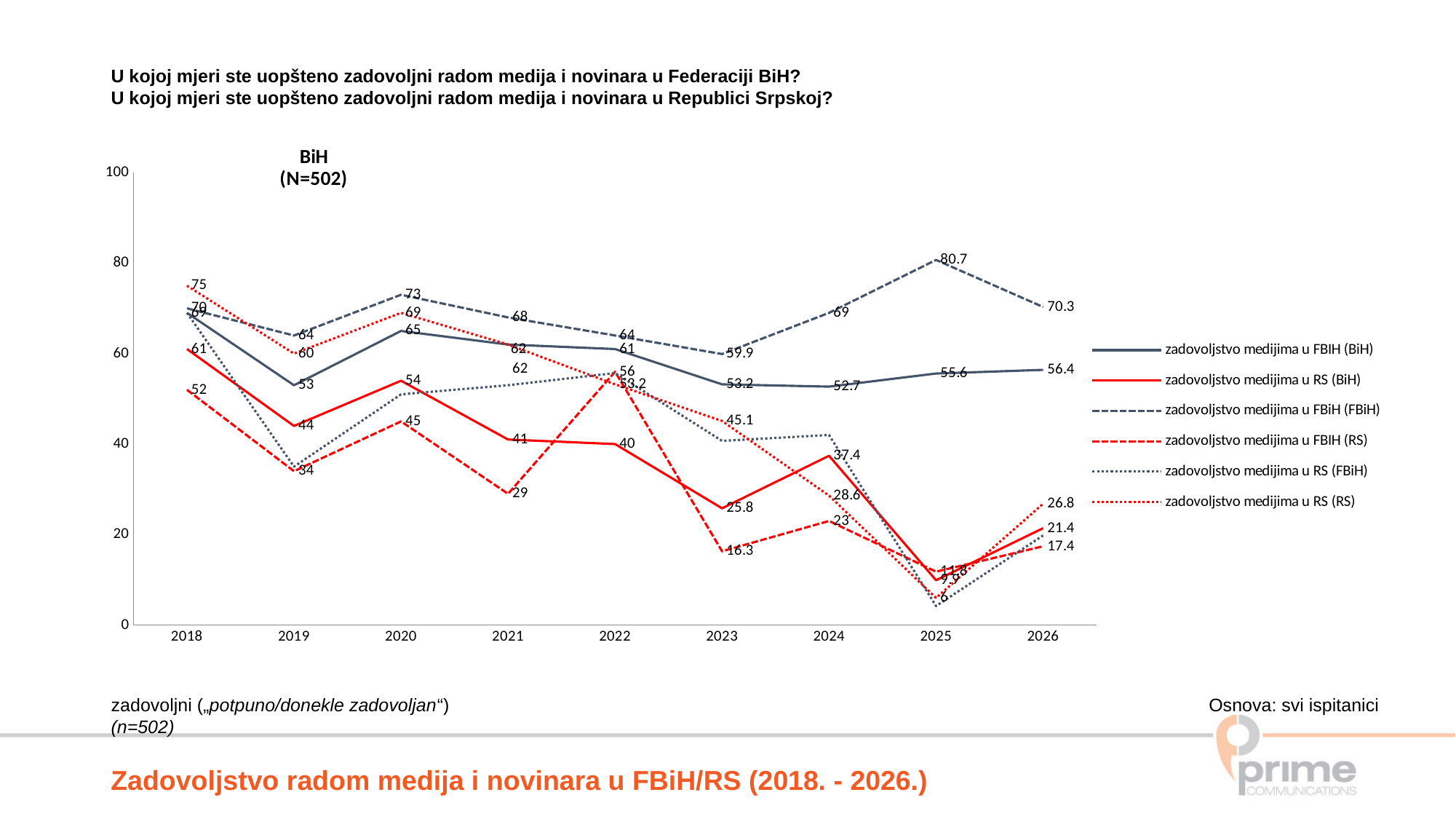
What is the value for 'zadovoljstvo medijima u FBIH (RS)' in 2021? 29 How many years are shown on the x axis? 9 In 2023, which is larger: 'zadovoljstvo medijima u RS (BiH)' or 'zadovoljstvo medijima u FBIH (RS)'? zadovoljstvo medijima u RS (BiH) How many series does the legend list? 6 In which year does 'zadovoljstvo medijima u FBiH (FBiH)' reach its highest value? 2025 What is the value for 'zadovoljstvo medijima u FBiH (FBiH)' in 2025? 80.7 What is the value for 'zadovoljstvo medijima u FBIH (BiH)' in 2026? 56.4 What is the sample size (N) shown above the chart? N=502 What kind of chart is shown on the slide? line chart What is the value for 'zadovoljstvo medijima u RS (RS)' in 2018? 75 What is the difference between 'zadovoljstvo medijima u FBiH (FBiH)' and 'zadovoljstvo medijima u FBIH (BiH)' in 2026? 13.9 In which year does 'zadovoljstvo medijima u RS (BiH)' reach its lowest value? 2025